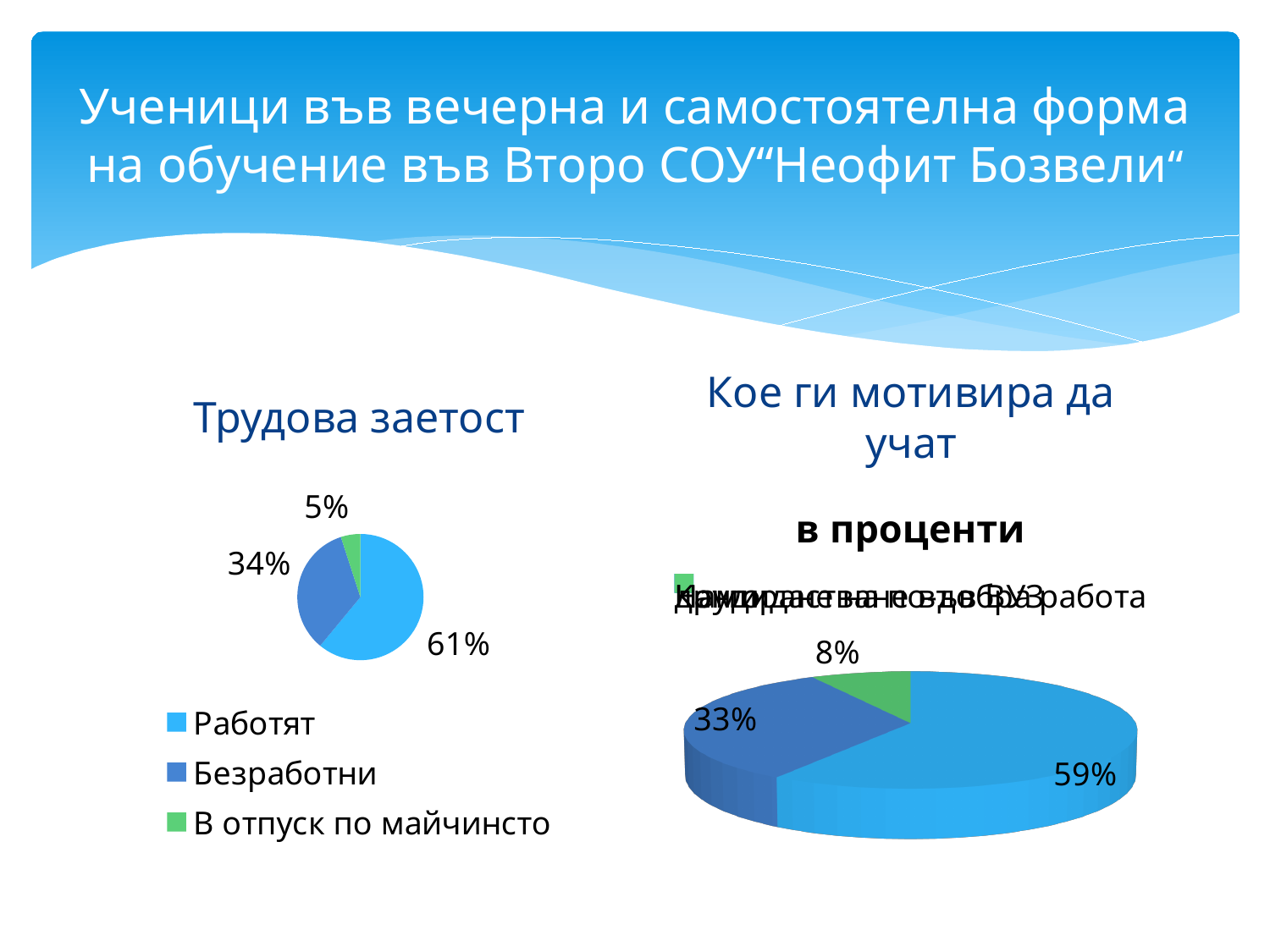
In the "Трудова заетост" chart, what is the difference in percentage points between Работят and Безработни? 27 How many categories does the legend of the "Трудова заетост" chart list? 3 In the "Кое ги мотивира да учат" chart, what is the smallest percentage shown? 8% In the "Трудова заетост" chart, which category has the largest share? Работят In the "Трудова заетост" chart, which is larger, Безработни or В отпуск по майчинсто? Безработни In the "Трудова заетост" chart, what percentage is shown for Безработни? 34% In the "Трудова заетост" chart, which category has the smallest share? В отпуск по майчинсто In the "Трудова заетост" chart, what percentage is shown for Работят? 61% In the "Кое ги мотивира да учат" chart, what is the largest percentage shown? 59% What type of chart is the "Трудова заетост" chart? Pie chart In the "Трудова заетост" chart, what percentage is shown for В отпуск по майчинсто? 5% How many slices does the "Кое ги мотивира да учат" pie chart have? 3